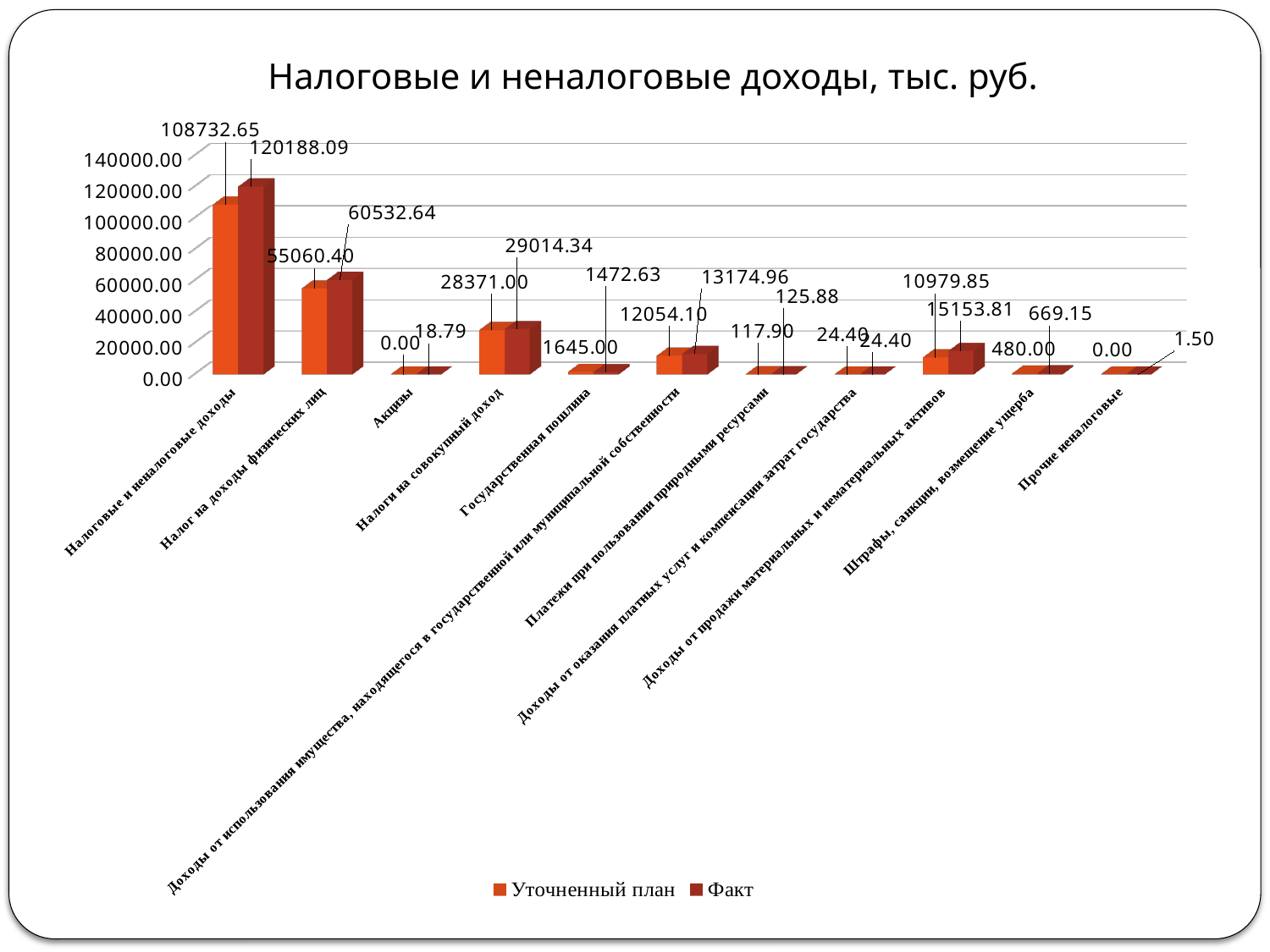
What is the Факт value for Налог на доходы физических лиц? 60532.64 What is the Уточненный план value for Акцизы? 0.00 What is the title of the chart? Налоговые и неналоговые доходы, тыс. руб. What is the Факт value for Штрафы, санкции, возмещение ущерба? 669.15 How many categories are shown on the x axis? 11 What is the Уточненный план value for Налоги на совокупный доход? 28371.00 Which category has the highest Факт value? Налоговые и неналоговые доходы What is the difference between the Факт and Уточненный план values for Налоговые и неналоговые доходы? 11455.44 What kind of chart is shown on the slide? Bar chart How many series does the legend list? 2 Which category has the lowest Факт value? Прочие неналоговые For Государственная пошлина, which is larger: Уточненный план or Факт? Уточненный план